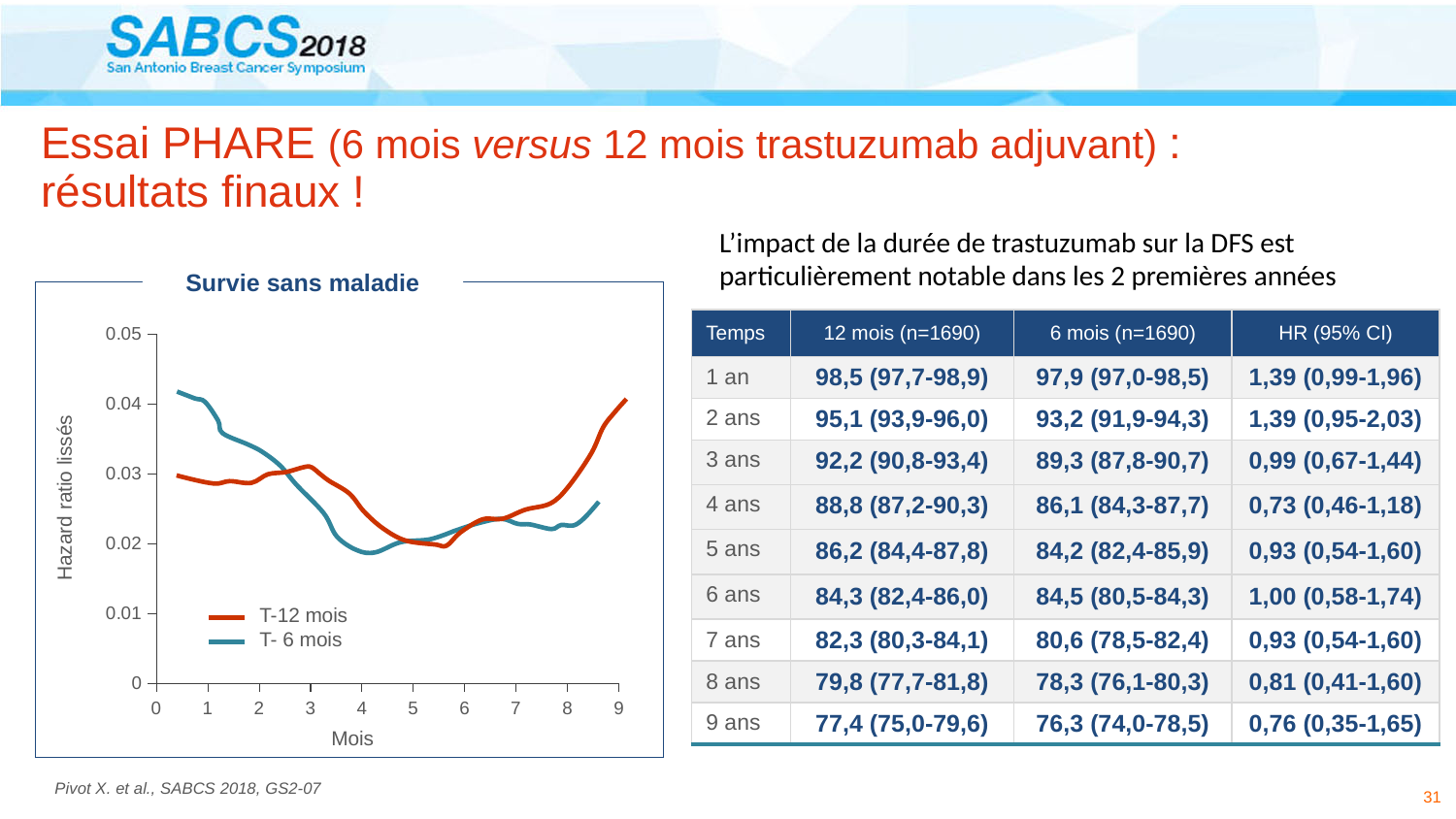
At month 1, which series has the higher value, T-12 mois or T- 6 mois? T- 6 mois What kind of chart is shown on the slide? line chart Does the T-12 mois line rise or fall between month 7 and month 9? rise What is the title of the chart? Survie sans maladie Is the value for T- 6 mois at month 4 greater or less than 0.03? less Does the T- 6 mois line rise or fall between month 0 and month 4? fall At month 3, which series has the higher value, T-12 mois or T- 6 mois? T-12 mois Is the value for T-12 mois at month 9 greater or less than 0.03? greater How many series does the legend of the chart list? 2 Is the value for T-12 mois at month 1 greater or less than 0.04? less What is the label of the vertical axis of the chart? Hazard ratio lissés